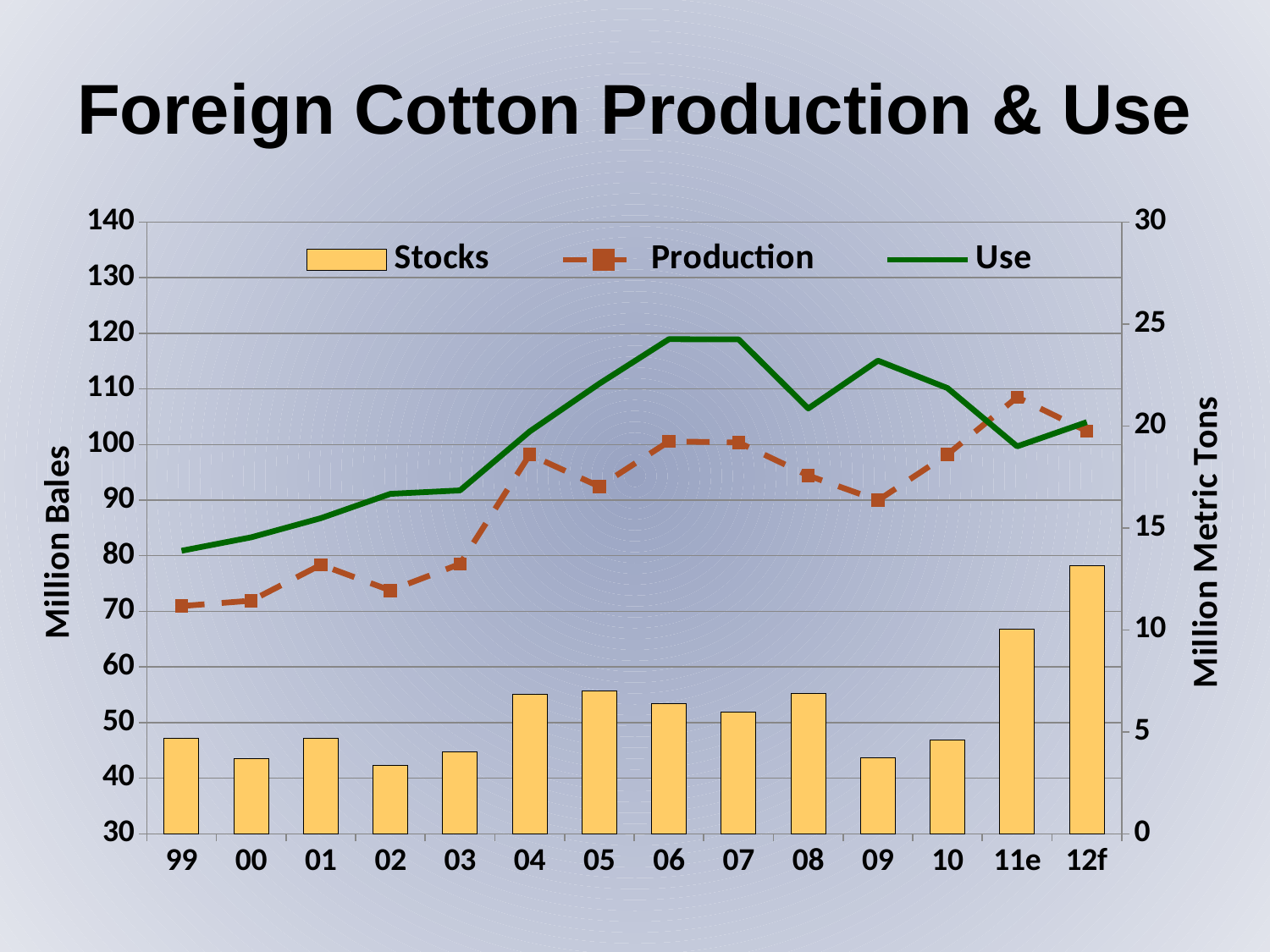
Which year has the highest Stocks bar? 12f Is the Stocks value for 99 greater or less than 50 on the Million Bales axis? less Which is larger in 06, Use or Production? Use What kind of chart is shown on the slide? A combination bar and line chart How many years (categories) are shown along the x axis? 14 What is the title of the chart? Foreign Cotton Production & Use Which is larger in 11e, Production or Use? Production Is the Stocks value for 12f greater or less than 70 on the Million Bales axis? greater How many series does the legend list? 3 In which year does the Production line reach its highest point? 11e Does the Use line rise or fall from 99 to 06? Rises Is the Use value for 06 greater or less than 20 on the Million Metric Tons axis? greater